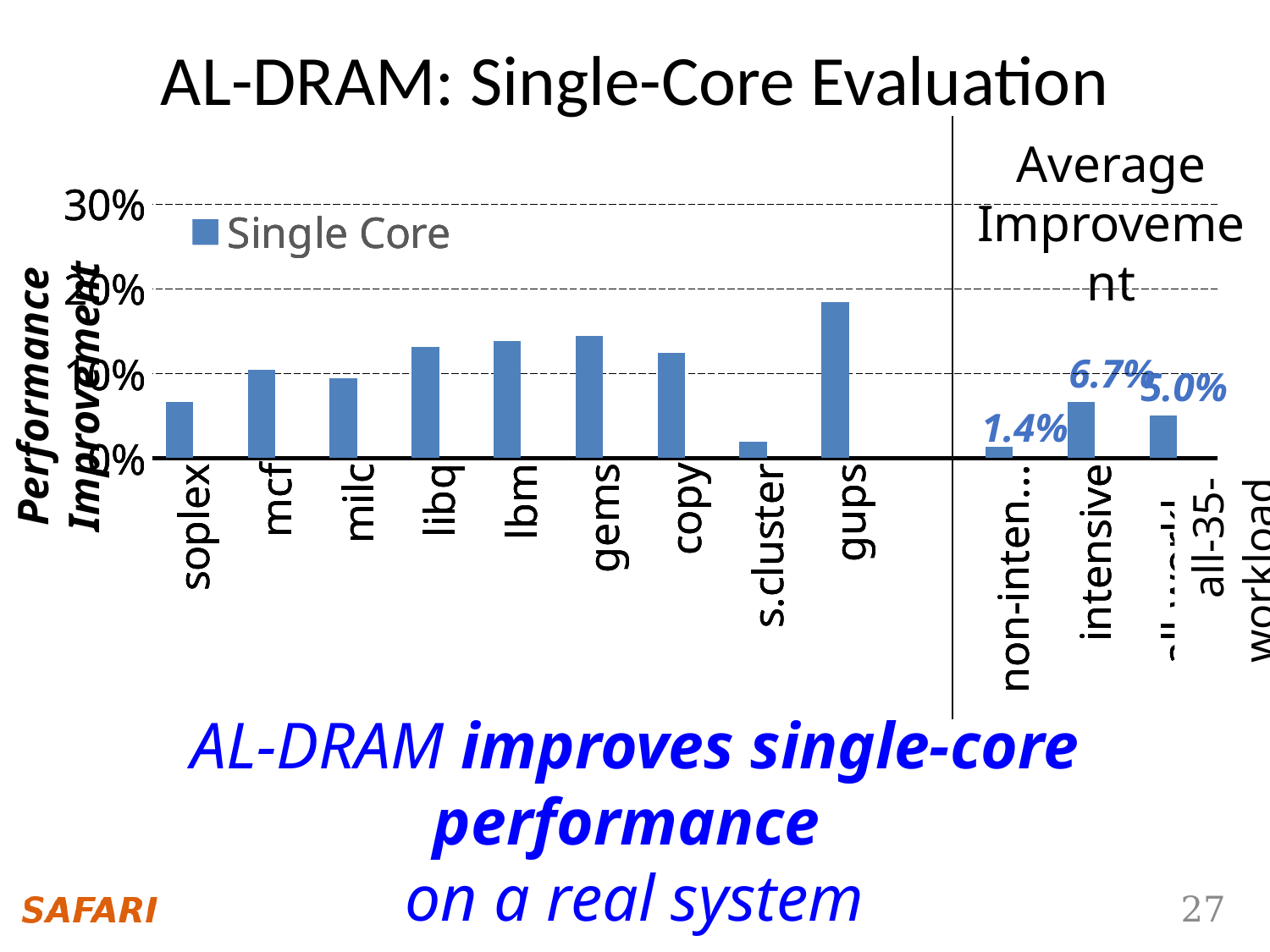
Which benchmark has the highest single-core performance improvement? gups Is the performance improvement for gups greater or less than 10%? greater Is the performance improvement for soplex greater or less than 10%? less What is the average improvement value labeled for the all-35-workload group? 5.0% What kind of chart is shown on the slide? bar chart How many series does the legend list? 1 What is the average improvement value labeled for the non-intensive workloads? 1.4% What is the difference between the average improvement for intensive workloads and for non-intensive workloads? 5.3% Which has a larger average improvement, intensive or non-intensive workloads? intensive What is the legend entry shown on the chart? Single Core Among the nine individual benchmarks to the left of the vertical divider, which has the lowest performance improvement? s.cluster What is the average improvement value labeled for the intensive workloads? 6.7%